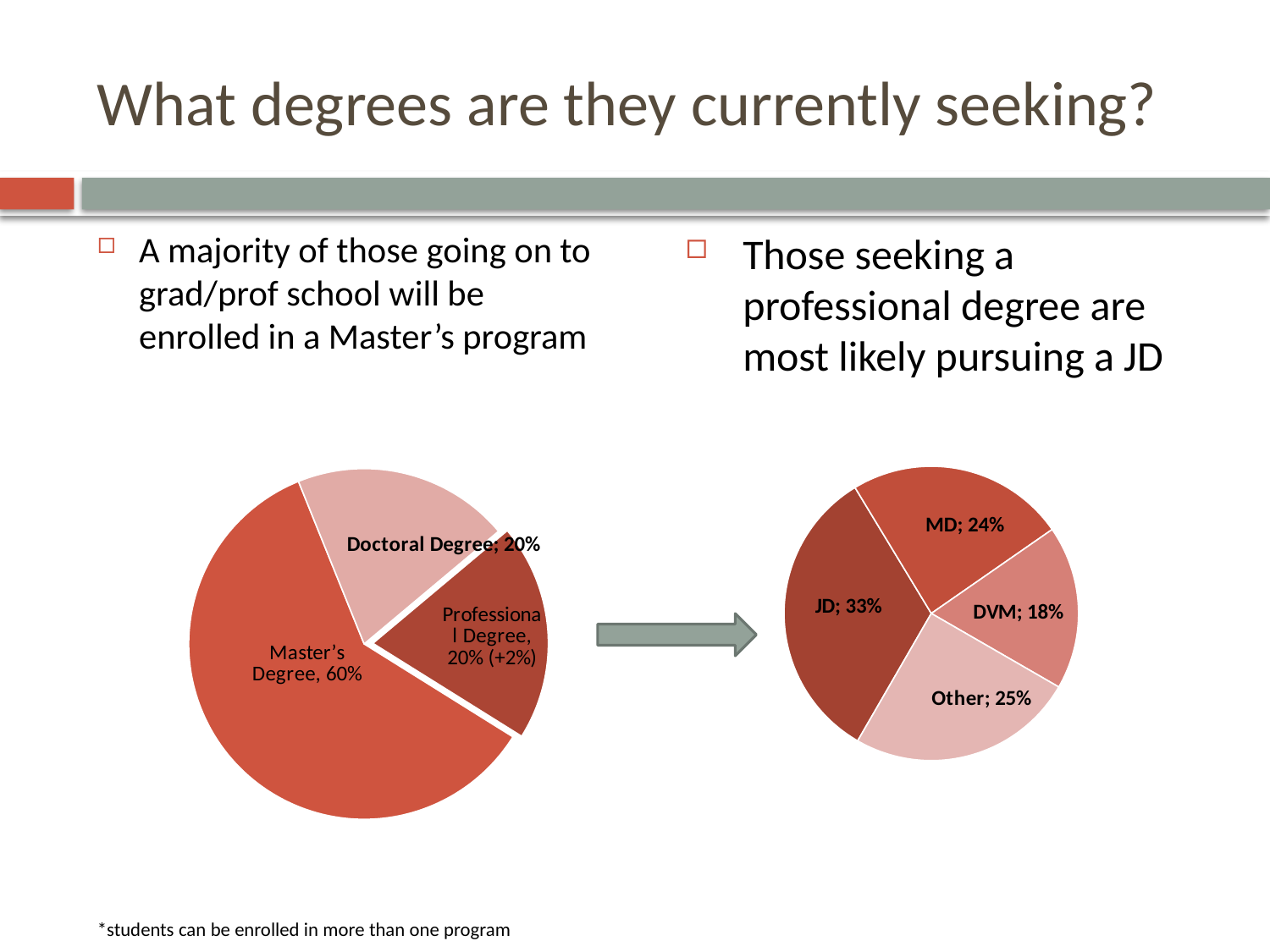
How many slices does the right pie chart have? 4 What kind of chart is the left chart on the slide? Pie chart In the right pie chart, which category has the smallest slice? DVM In the left pie chart, which degree type has the largest slice? Master's Degree In the right pie chart, what share is labelled for MD? 24% In the left pie chart, what share is labelled for Doctoral Degree? 20% In the right pie chart, what share is labelled for DVM? 18% In the right pie chart, what is the difference between the JD share and the MD share? 9% In the left pie chart, what share is labelled for Master's Degree? 60% How many slices does the left pie chart have? 3 In the right pie chart, which category has the largest slice? JD In the right pie chart, what share is labelled for JD? 33%